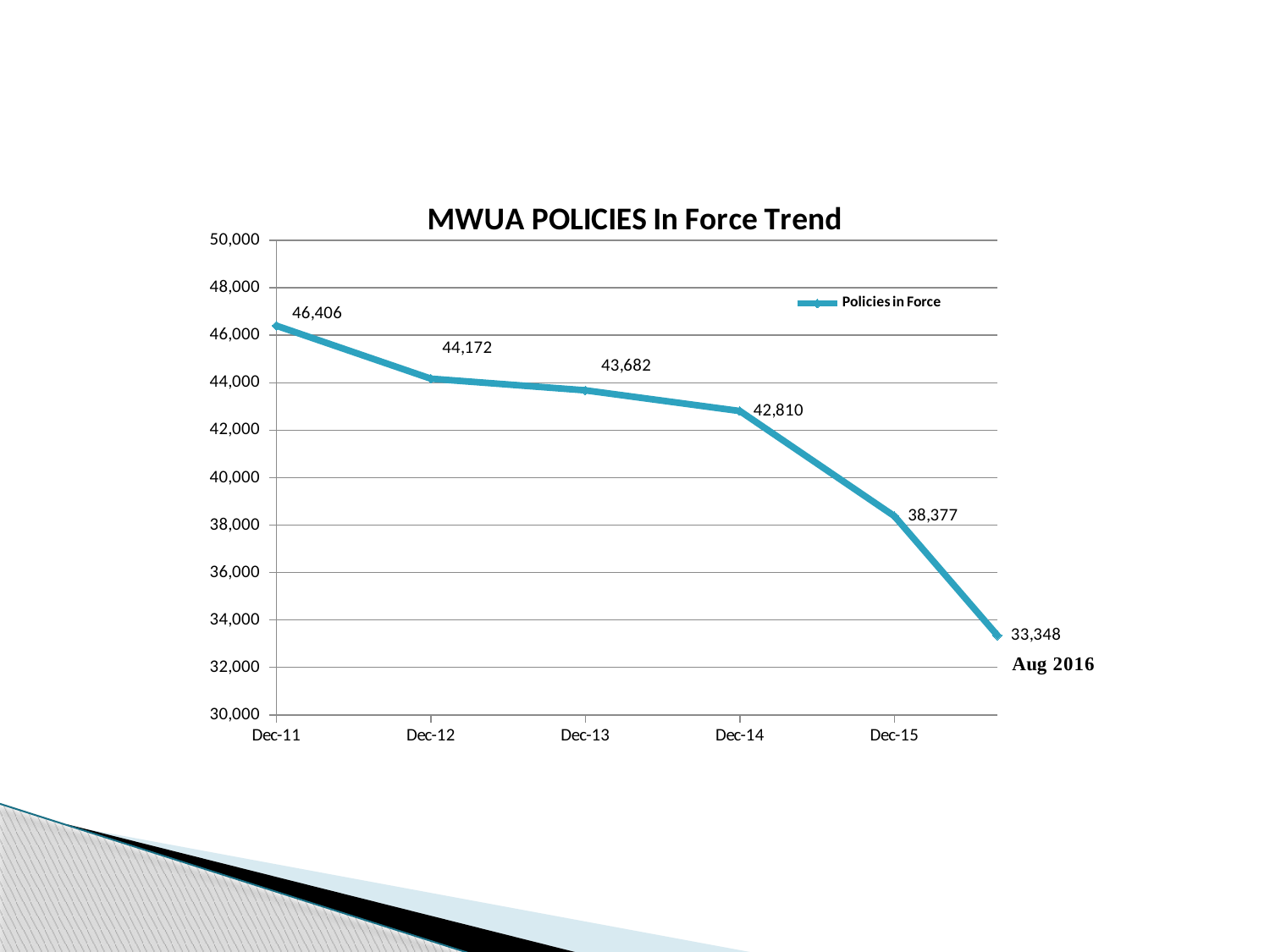
How many data points are plotted on the line? 6 Which is larger, the Policies in Force at Dec-12 or at Dec-14? Dec-12 What is the difference in Policies in Force between Dec-14 and Dec-15? 4,433 At which point is the number of Policies in Force lowest? Aug 2016 What is the value of Policies in Force at Dec-11? 46,406 What is the difference in Policies in Force between Dec-11 and Aug 2016? 13,058 What is the value of Policies in Force at Dec-13? 43,682 At which point is the number of Policies in Force highest? Dec-11 What is the value of Policies in Force at Dec-15? 38,377 What is the value of Policies in Force at Aug 2016? 33,348 What kind of chart is shown on the slide? Line chart Do the Policies in Force values rise or fall from Dec-11 to Aug 2016? Fall